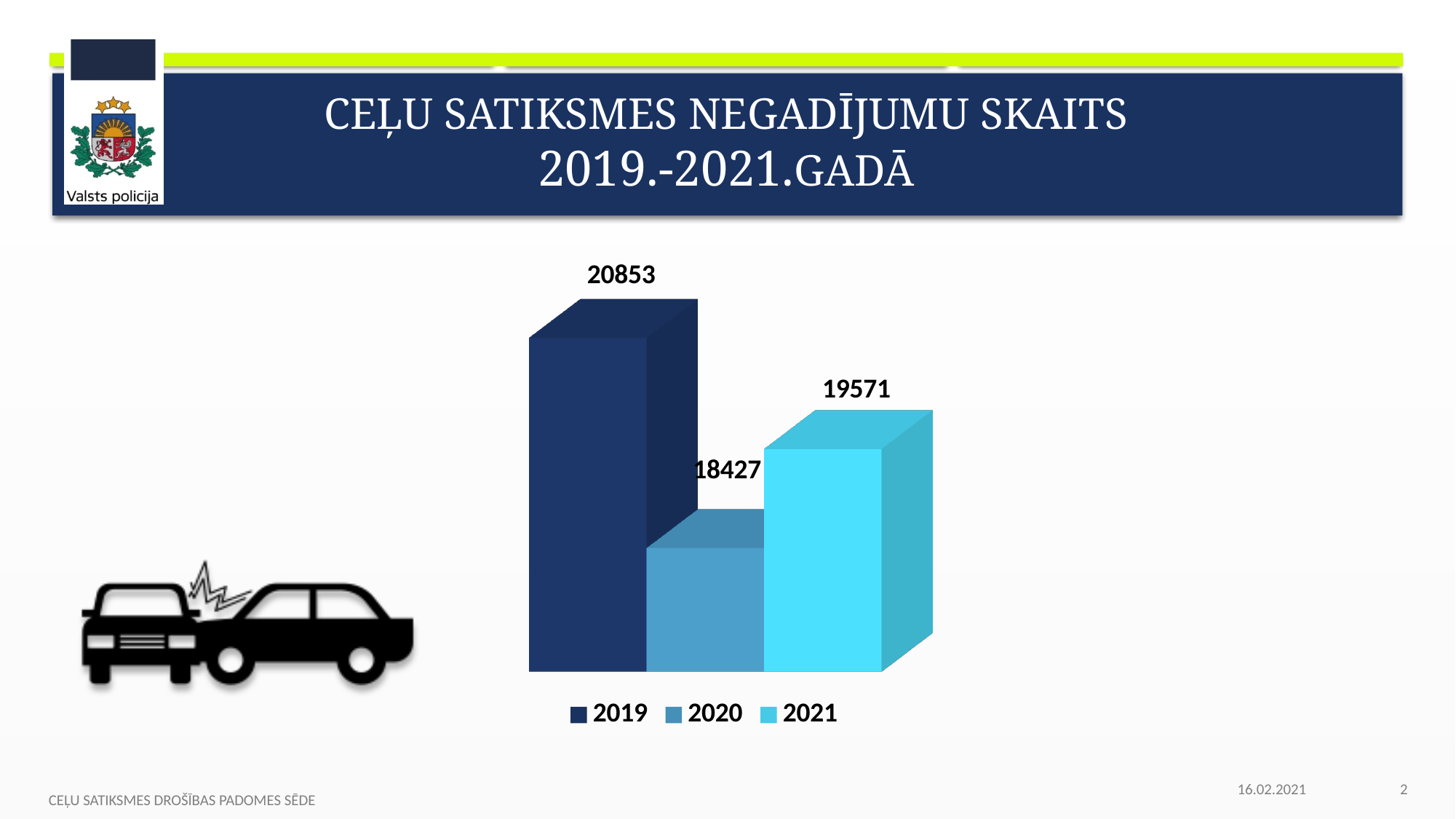
Which year has the highest number of accidents? 2019 What kind of chart is shown on the slide? bar chart How many entries does the legend list? 3 Which is larger, the value for 2020 or the value for 2021? 2021 What is the number of road traffic accidents shown for 2019? 20853 What is the difference between the 2021 and 2020 values? 1144 How many bars are plotted in the chart? 3 What is the number of road traffic accidents shown for 2021? 19571 What is the difference between the 2019 and 2020 values? 2426 Which year has the lowest number of accidents? 2020 Which legend entry is shown in the lightest blue colour? 2021 What is the number of road traffic accidents shown for 2020? 18427